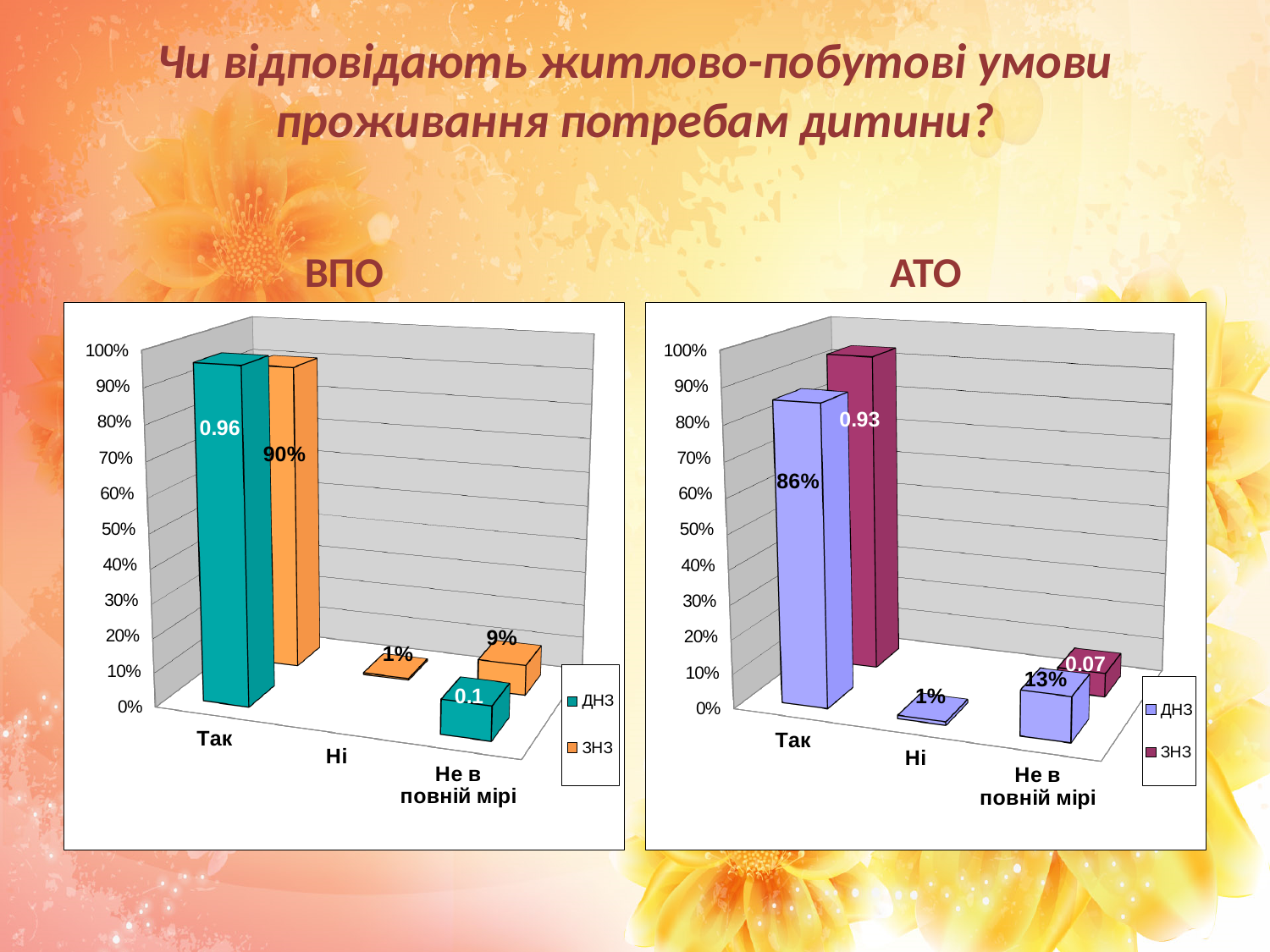
In the ВПО chart, what is the value labelled on the ДНЗ bar for Не в повній мірі? 0.1 In the АТО chart, what is the value labelled on the ДНЗ bar for Так? 86% In the ВПО chart, what is the value labelled on the ДНЗ bar for Так? 0.96 How many series does the legend of the ВПО chart list? 2 What type of chart is the АТО chart? Bar chart In the АТО chart, which category has the highest ДНЗ value? Так In the ВПО chart, what is the value labelled on the ЗНЗ bar for Так? 90% In the ВПО chart, what is the value labelled on the ЗНЗ bar for Не в повній мірі? 9% In the АТО chart, what is the value labelled on the ЗНЗ bar for Так? 0.93 In the АТО chart, what is the value labelled on the ДНЗ bar for Не в повній мірі? 13% In the АТО chart, what is the value labelled on the ЗНЗ bar for Не в повній мірі? 0.07 In the ВПО chart, which category has the lowest ЗНЗ value? Ні